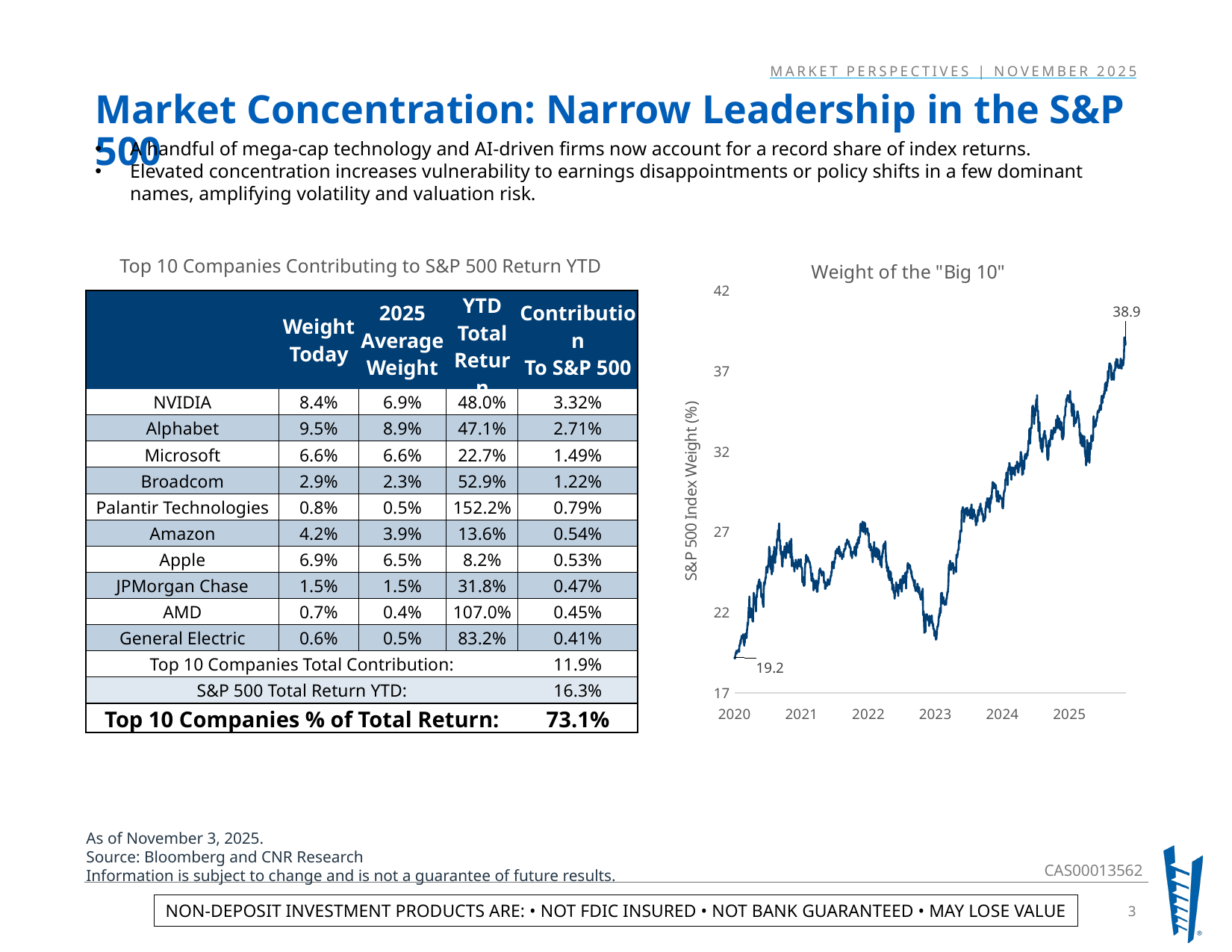
What kind of chart is "Weight of the "Big 10""? line chart In the "Weight of the "Big 10"" chart, what is the highest value labeled on the line? 38.9 In the "Weight of the "Big 10"" chart, is the value at the low point in early 2023 greater or less than 22? less In the "Weight of the "Big 10"" chart, is the labeled value at the end of 2025 larger or smaller than the labeled value at the start of 2020? larger What is the title of the line chart on the right side of the slide? Weight of the "Big 10" In the "Weight of the "Big 10"" chart, what is the difference between the labeled end value (38.9) and the labeled start value (19.2)? 19.7 How many years are labeled on the x axis of the "Weight of the "Big 10"" chart? 6 In the "Weight of the "Big 10"" chart, what is the value labeled at the end of the line in 2025? 38.9 What is the y-axis label of the "Weight of the "Big 10"" chart? S&P 500 Index Weight (%) In the "Weight of the "Big 10"" chart, does the weight generally rise or fall from 2020 to 2025? rise In the "Weight of the "Big 10"" chart, what is the value labeled at the start of the line in 2020? 19.2 In the "Weight of the "Big 10"" chart, is the value in mid-2024 greater or less than 27? greater